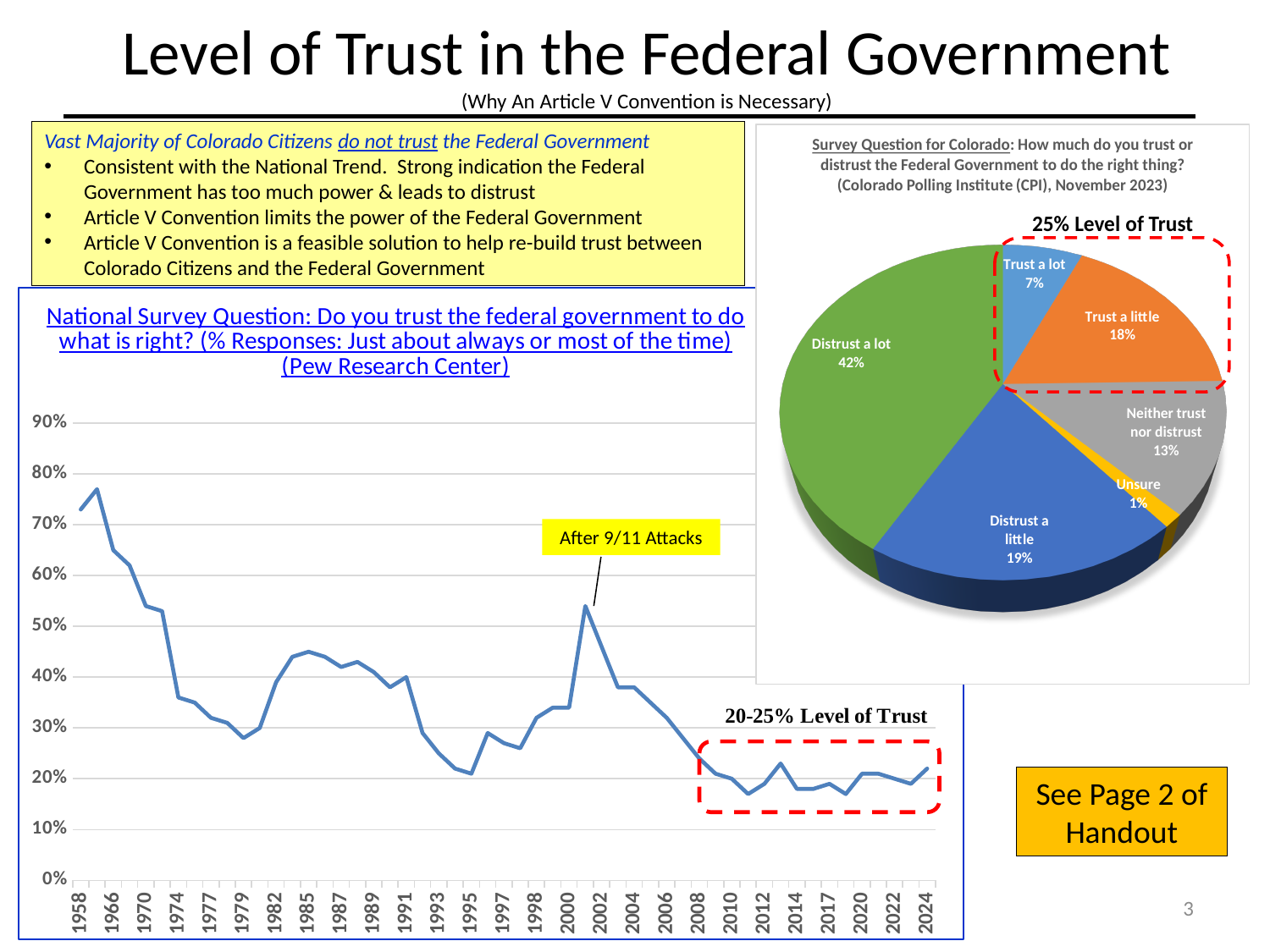
In the pie chart on the right, which response category has the largest share? Distrust a lot What kind of chart is the National Survey (Pew Research Center) chart on the left? line chart In the line chart on the left, is the value for 2024 greater or less than 30%? less In the line chart on the left, what event does the yellow annotation attribute the 2002 peak to? After 9/11 Attacks In the pie chart on the right, what is the combined share of "Trust a lot" and "Trust a little"? 25% How many slices does the pie chart on the right have? 6 In the pie chart on the right, what is the difference in percentage points between "Trust a little" and "Trust a lot"? 11% In the pie chart on the right, what percentage of respondents answered "Distrust a lot"? 42% In the pie chart on the right, which response category has the smallest share? Unsure In the pie chart on the right, what percentage of respondents answered "Trust a little"? 18% In the line chart on the left, is the value for 1958 greater or less than 70%? greater In the pie chart on the right, which is larger: "Distrust a little" or "Neither trust nor distrust"? Distrust a little